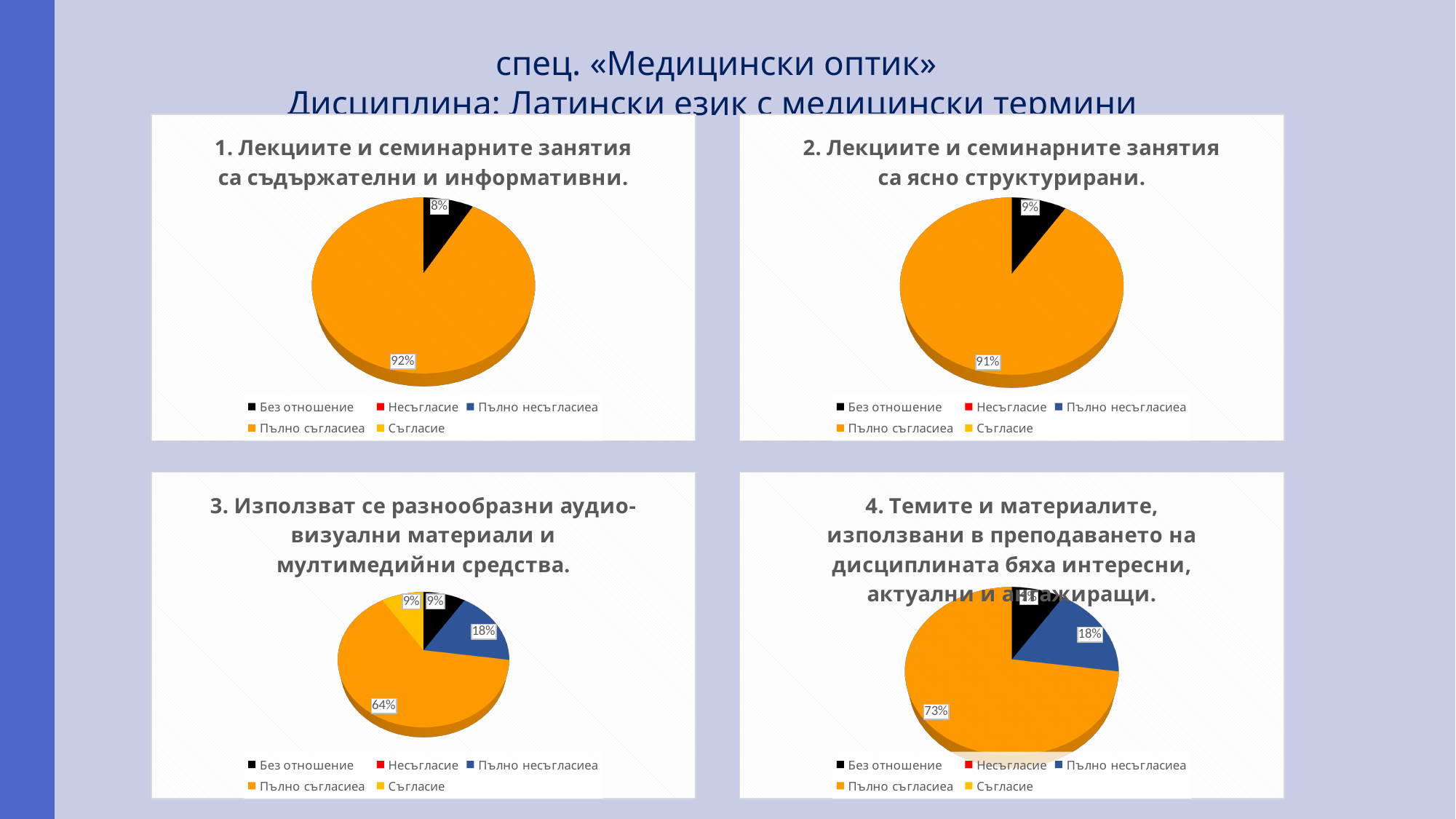
What type of chart is used in each of the four panels on the slide? Pie chart In the top-left chart (1. Лекциите и семинарните занятия са съдържателни и информативни), what colour is the Пълно съгласиеа slice? Orange How many entries does the legend list in the top-left chart (1. Лекциите и семинарните занятия са съдържателни и информативни)? 5 In the bottom-left chart (3. Използват се разнообразни аудио-визуални материали и мултимедийни средства), what is the difference between the Пълно съгласиеа slice and the Пълно несъгласиеа slice? 46% In the top-right chart (2. Лекциите и семинарните занятия са ясно структурирани), what percentage is shown for Без отношение? 9% In the bottom-right chart (4. Темите и материалите...), which is larger: the Пълно съгласиеа slice or the Пълно несъгласиеа slice? Пълно съгласиеа In the top-left chart (1. Лекциите и семинарните занятия са съдържателни и информативни), what share of the pie is labelled for Пълно съгласиеа? 92% In the bottom-right chart (4. Темите и материалите, използвани в преподаването на дисциплината бяха интересни, актуални и ангажиращи), what percentage is shown for Пълно съгласиеа? 73% In the bottom-left chart (3. Използват се разнообразни аудио-визуални материали и мултимедийни средства), what percentage is shown for Пълно несъгласиеа? 18% In the top-right chart (2. Лекциите и семинарните занятия са ясно структурирани), what percentage is shown for Пълно съгласиеа? 91% In the top-left chart (1. Лекциите и семинарните занятия са съдържателни и информативни), what percentage is shown for Без отношение? 8% In the bottom-left chart (3. Използват се разнообразни аудио-визуални материали и мултимедийни средства), which category has the largest slice? Пълно съгласиеа